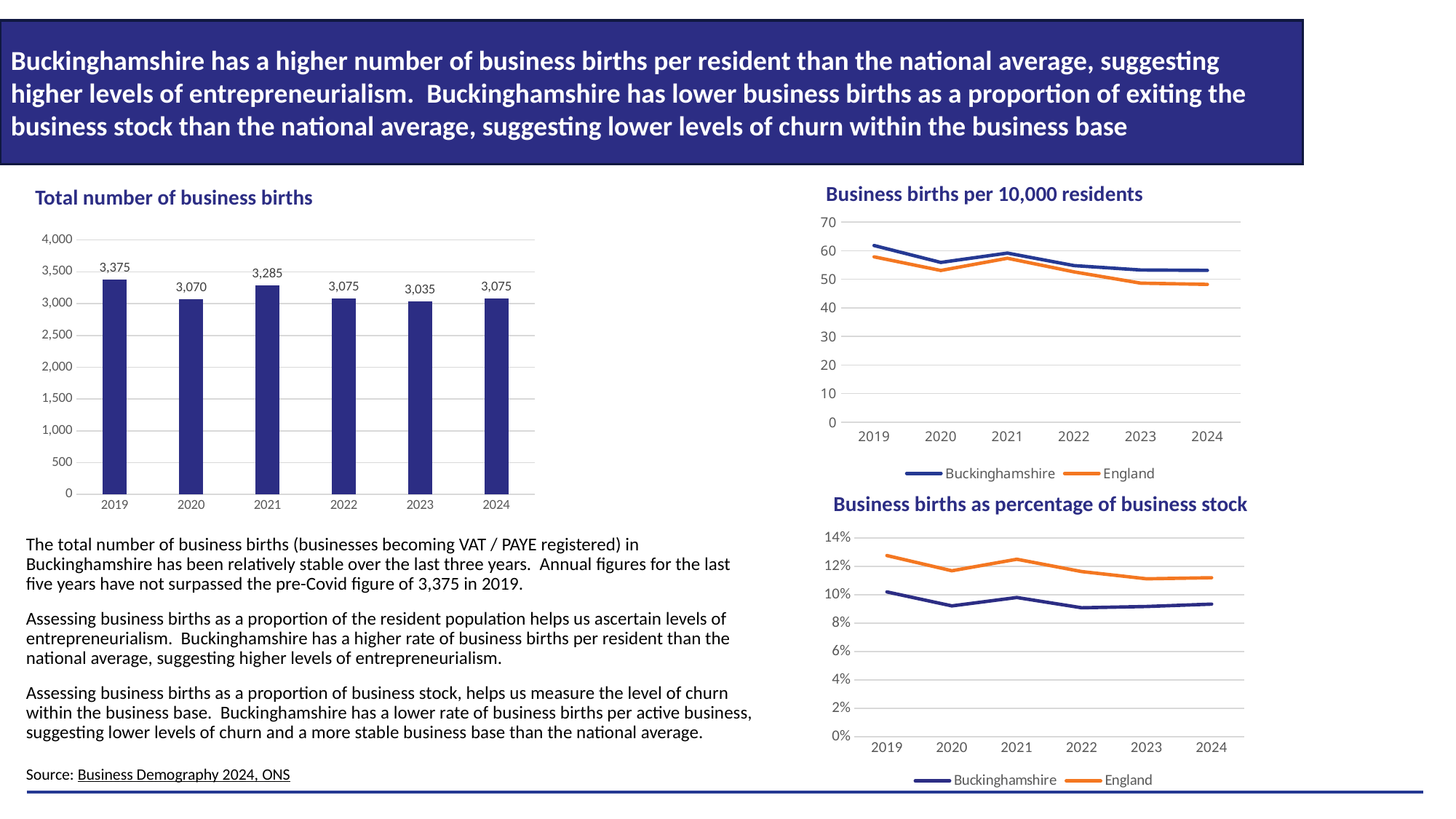
In the 'Total number of business births' chart, which year has the highest value? 2019 In the 'Total number of business births' chart, what is the value for 2023? 3,035 In the 'Business births per 10,000 residents' chart, how many series does the legend list? 2 In the 'Total number of business births' chart, what is the value for 2019? 3,375 In the 'Business births per 10,000 residents' chart, which series is higher in 2024, Buckinghamshire or England? Buckinghamshire In the 'Total number of business births' chart, which year has the lowest value? 2023 In the 'Business births per 10,000 residents' chart, is the Buckinghamshire value for 2019 greater or less than 60? greater In the 'Total number of business births' chart, how many years are shown? 6 In the 'Business births as percentage of business stock' chart, is the England value for 2019 greater or less than 12%? greater In the 'Total number of business births' chart, what is the difference between the 2019 and 2021 values? 90 In the 'Business births as percentage of business stock' chart, which series is higher in 2022, Buckinghamshire or England? England What kind of chart is 'Total number of business births'? Bar chart